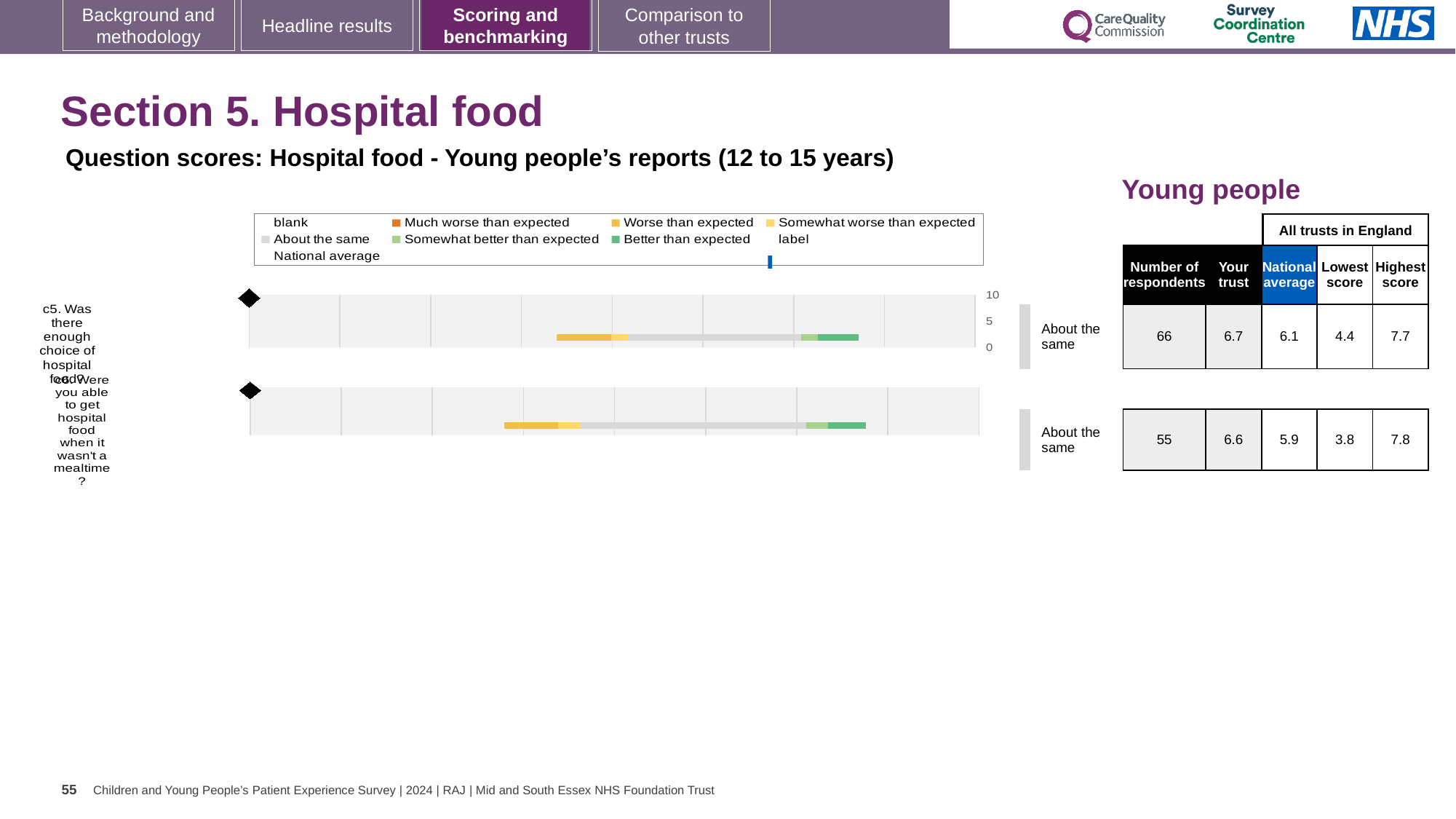
Which legend entry is shown in dark green in the hospital food chart? Better than expected What benchmark rating is given for question c6 (able to get hospital food when it wasn't a mealtime)? About the same What kind of chart is used to show the question scores for hospital food? bar chart In the table beside the chart, what is the difference between the highest score and the lowest score for question c6? 4.0 In the table beside the chart, how many respondents answered question c6? 55 In the table beside the chart, what is the national average for question c5? 6.1 What is the highest value shown on the chart's score axis? 10 What benchmark rating is given for question c5 (enough choice of hospital food)? About the same In the table beside the chart, what is the 'Your trust' score for question c5? 6.7 In the table beside the chart, what is the 'Your trust' score for question c6? 6.6 How many survey questions are plotted in the hospital food chart? 2 In the table beside the chart, which question has the higher 'Your trust' score, c5 or c6? c5